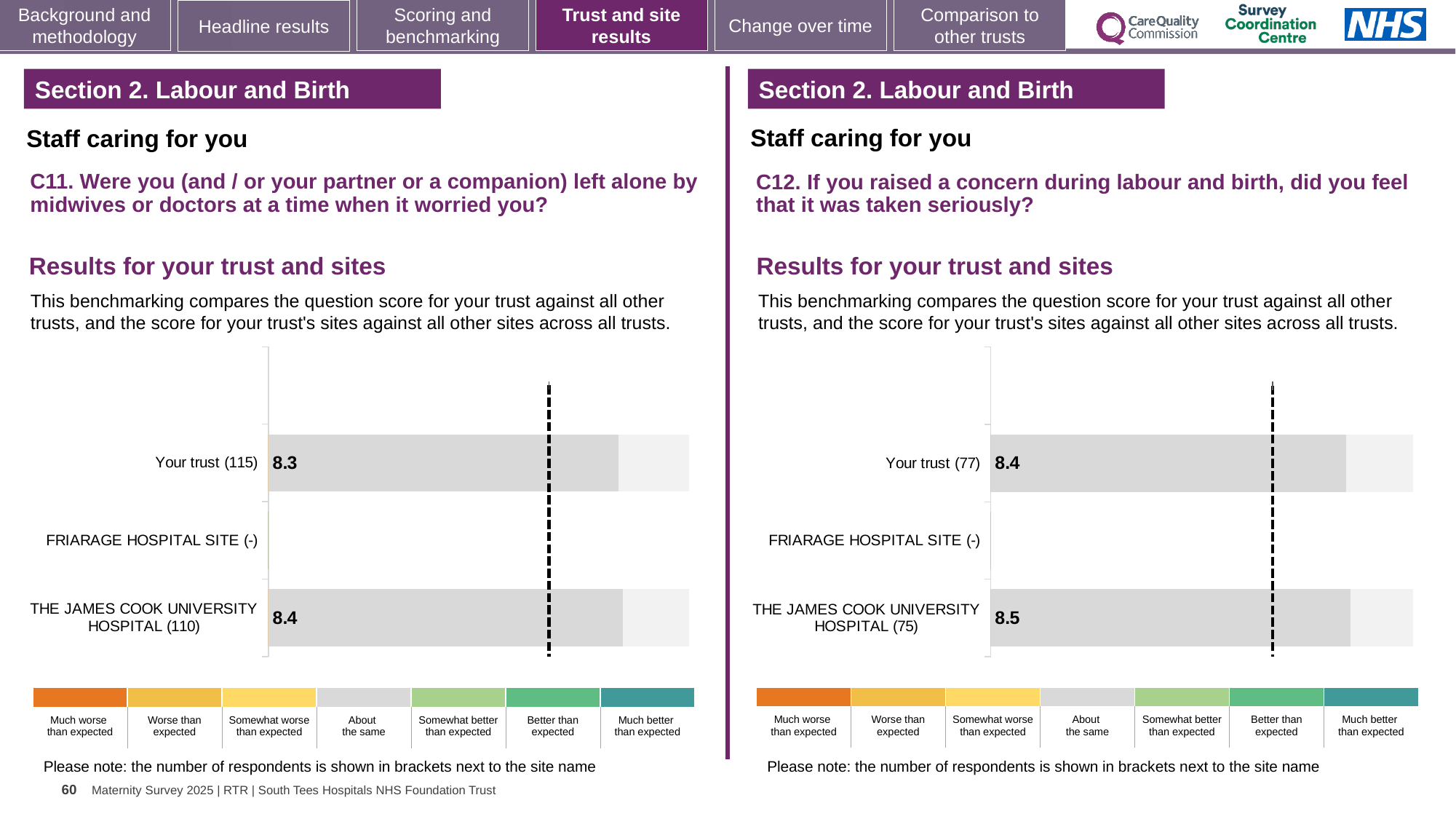
In the C12 chart on the right, what is the difference between the score for THE JAMES COOK UNIVERSITY HOSPITAL (75) and the score for Your trust (77)? 0.1 What kind of chart is used in the C12 chart on the right? Bar chart In the C11 chart on the left, what is the score for Your trust (115)? 8.3 In the C11 chart on the left, what is the difference between the score for THE JAMES COOK UNIVERSITY HOSPITAL (110) and the score for Your trust (115)? 0.1 In the C12 chart on the right, which site has no score bar shown? FRIARAGE HOSPITAL SITE (-) In the C12 chart on the right, which has the higher score: Your trust (77) or THE JAMES COOK UNIVERSITY HOSPITAL (75)? THE JAMES COOK UNIVERSITY HOSPITAL (75) In the C11 chart on the left, how many respondents are shown in brackets for Your trust? 115 In the C12 chart on the right, what is the score for THE JAMES COOK UNIVERSITY HOSPITAL (75)? 8.5 In the C12 chart on the right, what is the score for Your trust (77)? 8.4 How many categories (rows) are listed on the y axis of the C11 chart on the left? 3 In the C11 chart on the left, which has the higher score: Your trust (115) or THE JAMES COOK UNIVERSITY HOSPITAL (110)? THE JAMES COOK UNIVERSITY HOSPITAL (110) In the C11 chart on the left, what is the score for THE JAMES COOK UNIVERSITY HOSPITAL (110)? 8.4